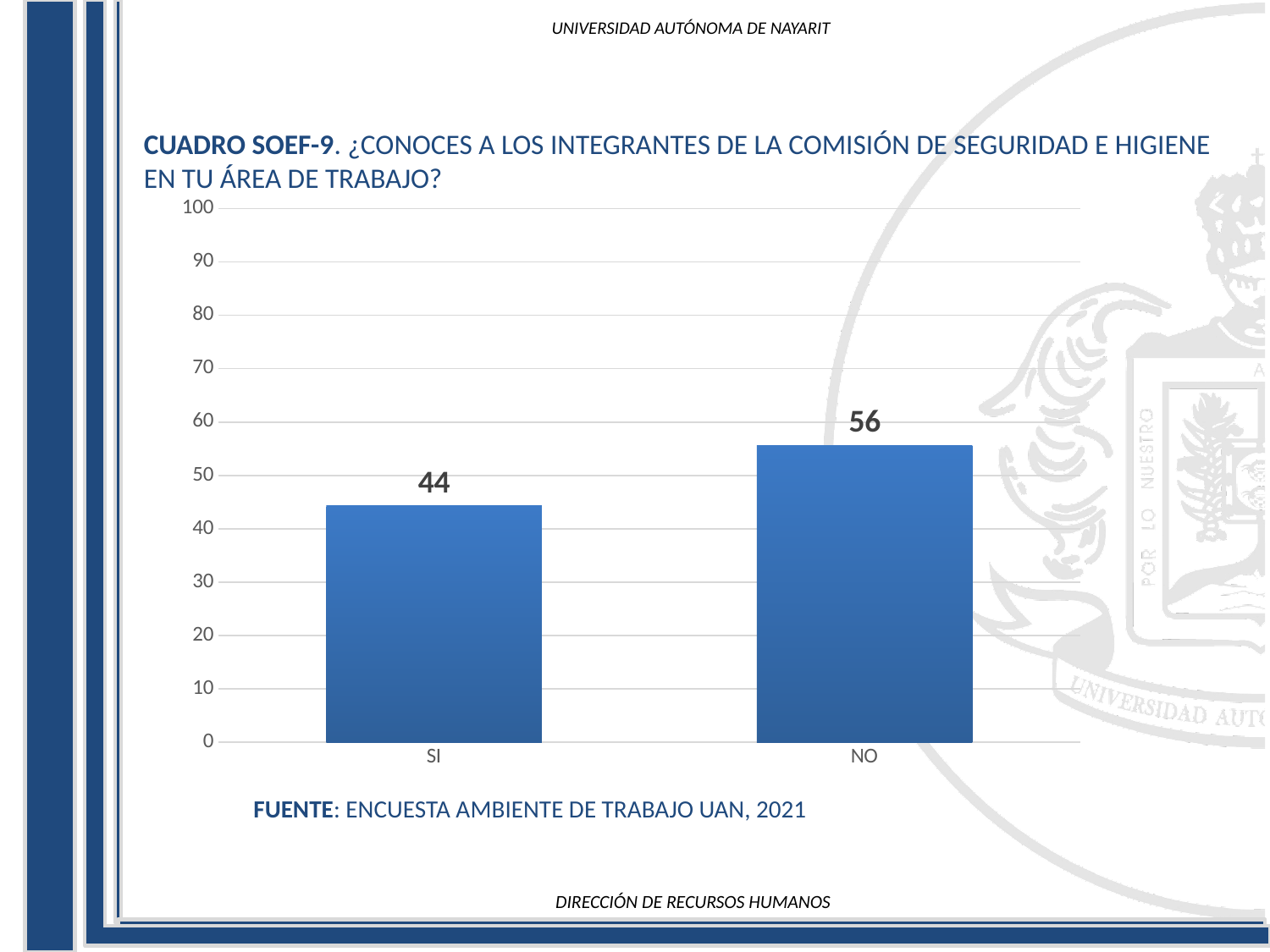
How many categories are shown on the x axis? 2 What is the value for SI? 44 What kind of chart is shown on the slide? bar chart Which category has the highest value? NO Which is larger, the value for SI or the value for NO? NO Which category has the lowest value? SI Is the value for SI greater or less than 50? less What is the difference between the values for NO and SI? 12 Is the value for NO greater or less than 50? greater What is the source cited below the chart? ENCUESTA AMBIENTE DE TRABAJO UAN, 2021 What is the total of the two bars? 100 What is the value for NO? 56